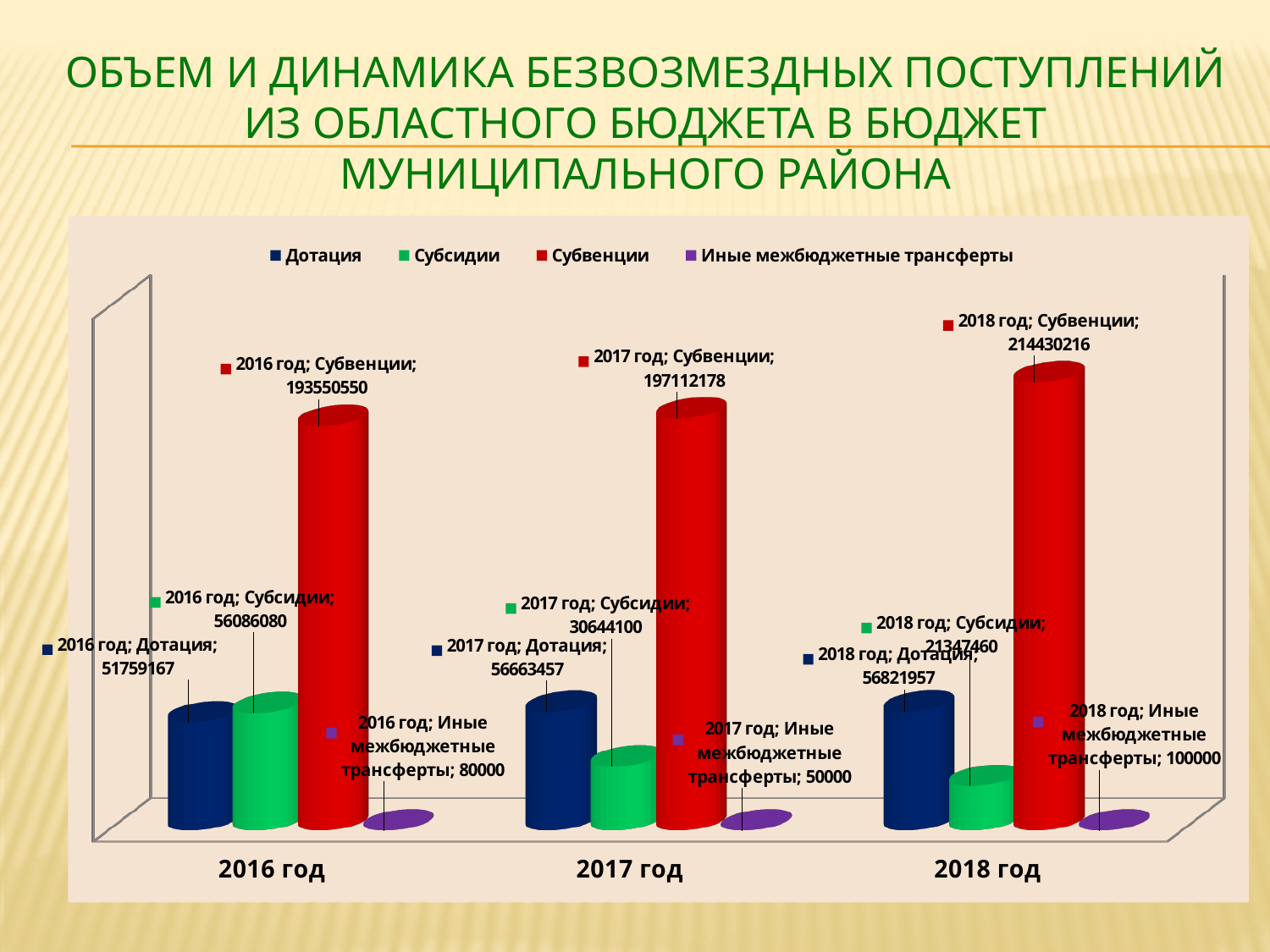
What is the difference between the Субвенции values for 2018 год and 2017 год? 17318038 In which year is the value for Субсидии the lowest? 2018 год Do the values for Субсидии rise or fall from 2016 год to 2018 год? fall What is the value for Дотация in 2017 год? 56663457 What is the value for Субвенции in 2016 год? 193550550 In which year is the value for Субвенции the highest? 2018 год What is the difference between the Субсидии values for 2016 год and 2018 год? 34738620 How many series does the legend list? 4 Which is larger in 2016 год: Дотация or Субсидии? Субсидии How many years are shown on the x axis? 3 What is the value for Субсидии in 2018 год? 21347460 What is the value for Иные межбюджетные трансферты in 2017 год? 50000